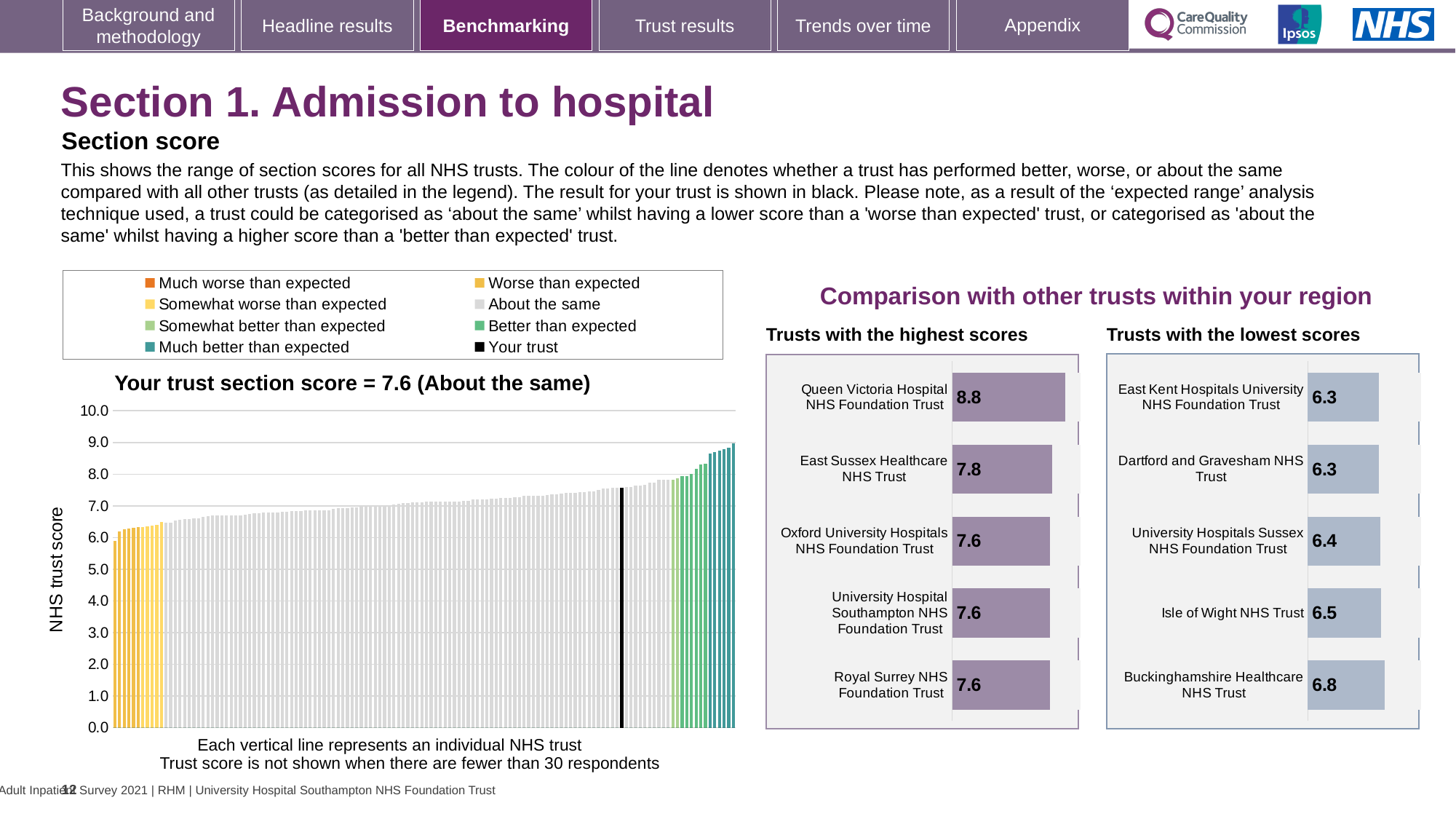
In the 'Your trust section score' chart on the left, what is the section score for your trust? 7.6 In the 'Trusts with the highest scores' chart, which trust has the highest score? Queen Victoria Hospital NHS Foundation Trust In the 'Your trust section score' chart on the left, do the trust scores rise or fall from left to right? Rise In the 'Trusts with the highest scores' chart, what is the score for East Sussex Healthcare NHS Trust? 7.8 What kind of chart is the 'Your trust section score' chart on the left? Bar chart In the 'Trusts with the lowest scores' chart, which has the larger score, Isle of Wight NHS Trust or University Hospitals Sussex NHS Foundation Trust? Isle of Wight NHS Trust In the 'Trusts with the lowest scores' chart, which trust has the highest score? Buckinghamshire Healthcare NHS Trust In the 'Trusts with the lowest scores' chart, what is the difference between the scores of Buckinghamshire Healthcare NHS Trust and East Kent Hospitals University NHS Foundation Trust? 0.5 In the 'Trusts with the highest scores' chart, how many trusts are listed? 5 In the 'Trusts with the lowest scores' chart, what is the score for Buckinghamshire Healthcare NHS Trust? 6.8 In the 'Trusts with the highest scores' chart, what is the score for Queen Victoria Hospital NHS Foundation Trust? 8.8 In the 'Trusts with the highest scores' chart, what is the difference between the scores of Queen Victoria Hospital NHS Foundation Trust and East Sussex Healthcare NHS Trust? 1.0